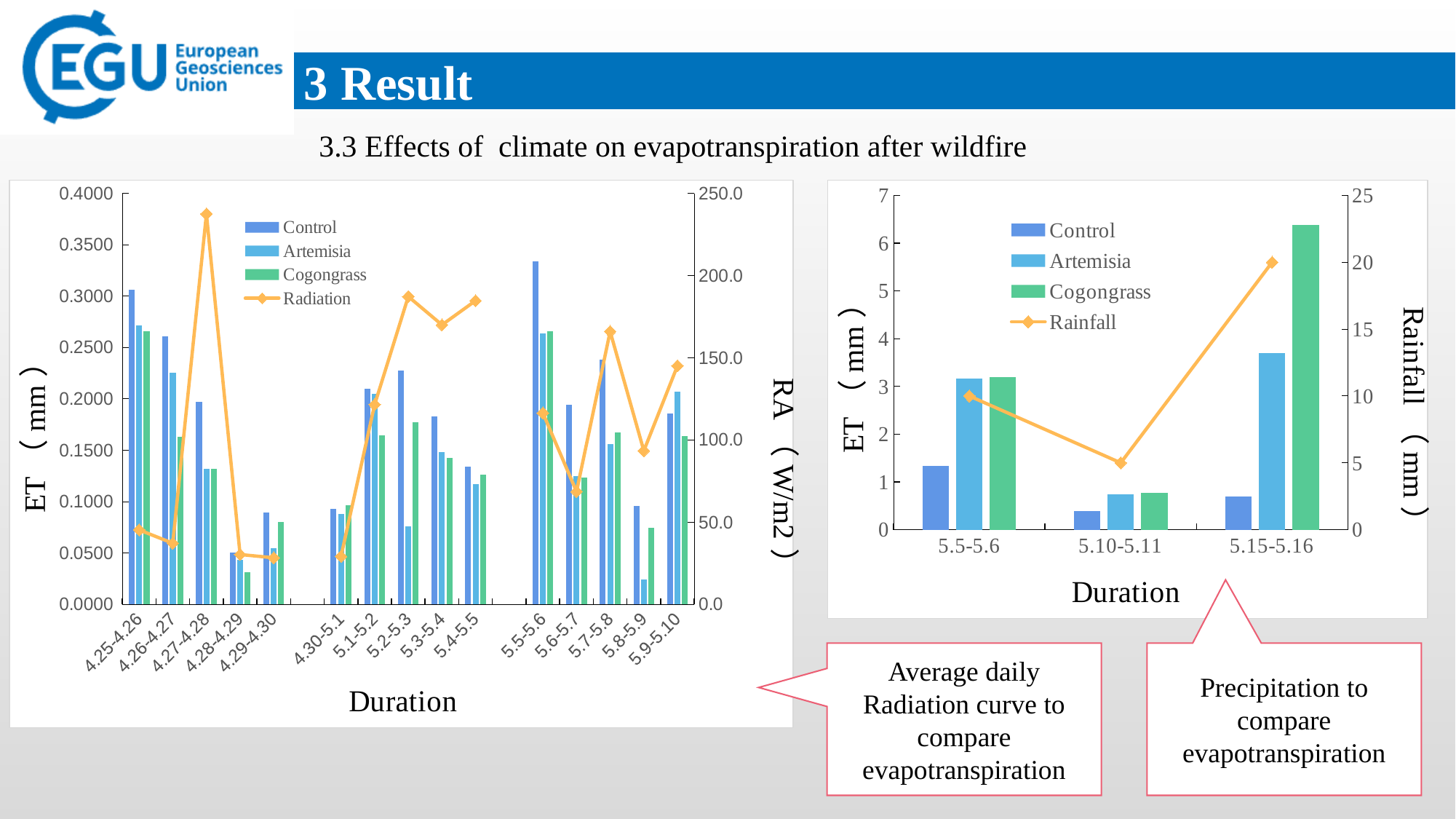
How many series does the legend of the right chart list? 4 In the right chart, is the Rainfall value for 5.15-5.16 greater or less than 15? greater In the left chart, which is larger for 5.8-5.9: the Control ET or the Artemisia ET? Control How many duration categories are shown on the x axis of the right chart? 3 What type of chart is the left chart? bar chart with a line In the left chart, for which duration is the Control ET highest? 5.5-5.6 In the left chart, is the Radiation value for 4.27-4.28 greater or less than 200.0? greater How many series does the legend of the left chart list? 4 In the right chart, which series has the highest ET for 5.15-5.16? Cogongrass In the left chart, is the Control ET value for 5.5-5.6 greater or less than 0.3000? greater How many duration categories are shown on the x axis of the left chart? 15 In the left chart, for which duration is Radiation highest? 4.27-4.28